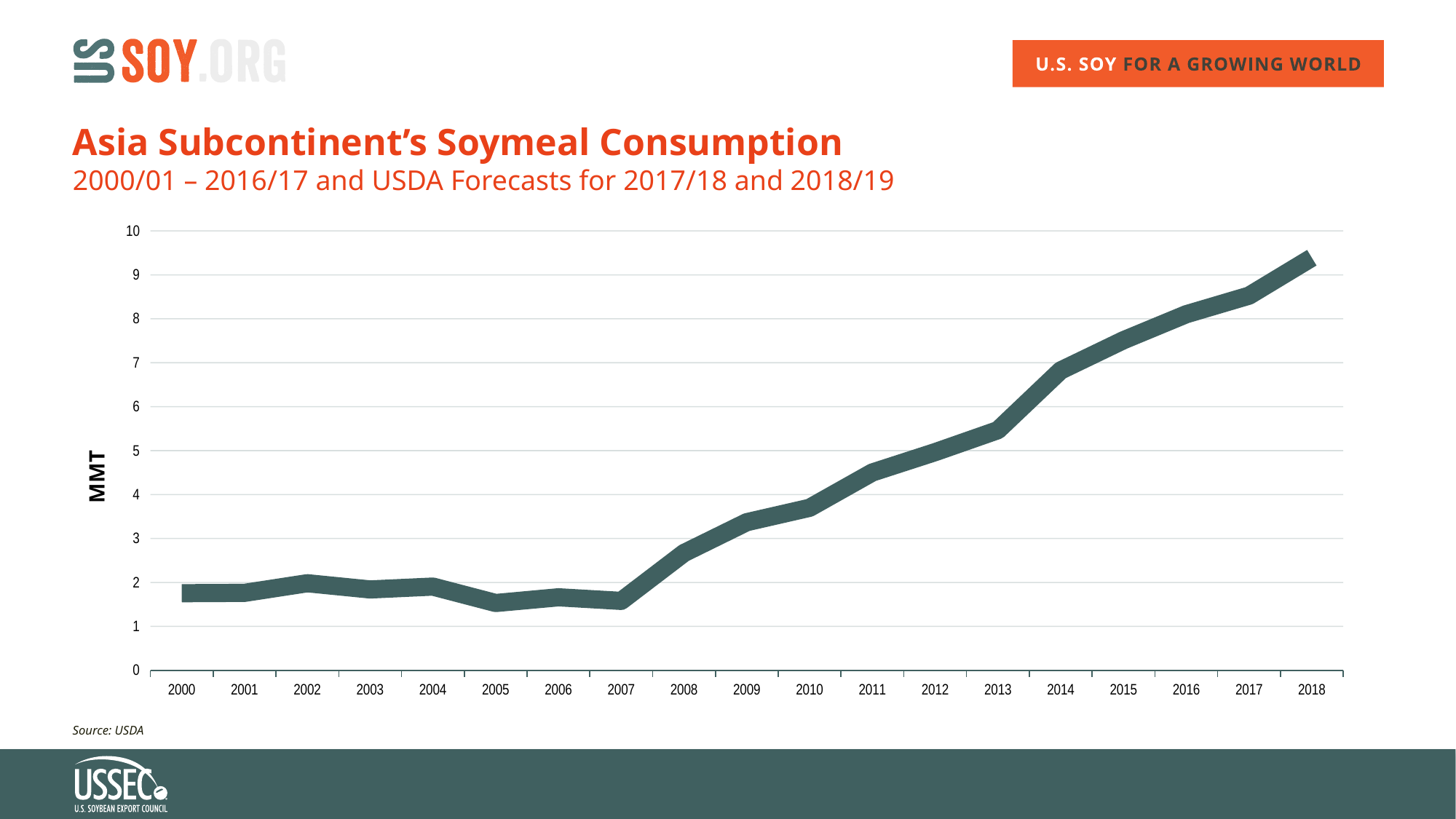
What kind of chart is shown on the slide? line chart Is the value for 2005 greater or less than 2? less Is the value for 2010 greater or less than 4? less How many years are plotted along the x axis of the chart? 19 Which year has the highest soymeal consumption in the chart? 2018 What source is cited for the chart data? USDA Do the values generally rise or fall from 2007 to 2018? rise What is the label on the y axis of the chart? MMT Is the value for 2014 greater or less than 6? greater Which is larger, the value for 2000 or the value for 2018? 2018